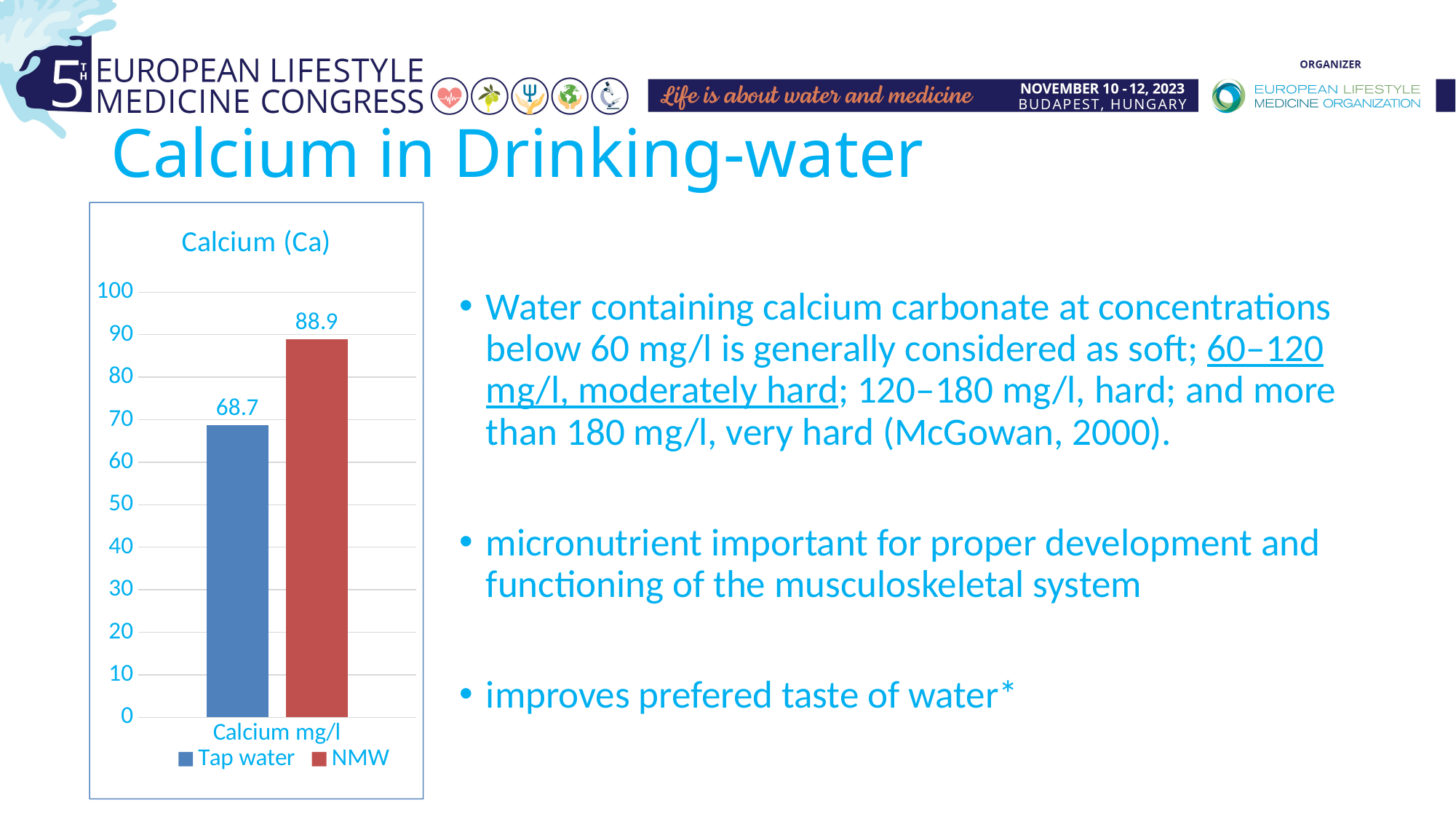
How many series does the legend list? 2 Which series has the higher calcium value, Tap water or NMW? NMW What is the category label on the x axis of the chart? Calcium mg/l What is the calcium value for Tap water? 68.7 What kind of chart is shown on the slide? bar chart What is the title of the chart? Calcium (Ca) Is the value for NMW greater or less than 90? less Which series has the lowest calcium value? Tap water Is the value for Tap water greater or less than 60? greater What is the difference between the NMW and Tap water calcium values? 20.2 What is the maximum value shown on the chart's y axis? 100 What is the calcium value for NMW? 88.9